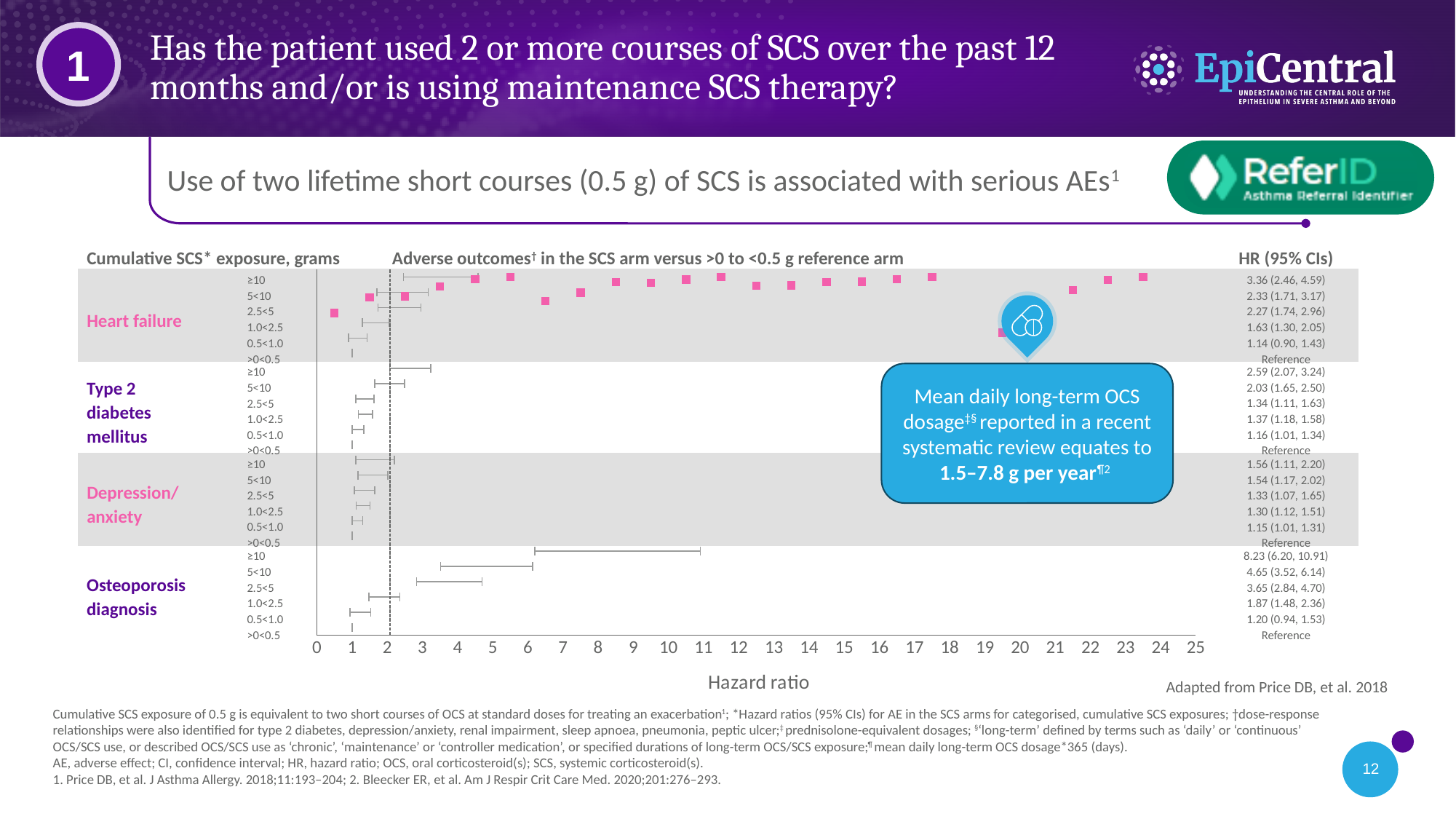
How many adverse outcome groups are shown in the chart? 4 What is the HR (95% CI) for type 2 diabetes mellitus at cumulative SCS exposure 0.5<1.0 g? 1.16 (1.01, 1.34) What is the HR (95% CI) for osteoporosis diagnosis at cumulative SCS exposure ≥10 g? 8.23 (6.20, 10.91) Which is larger: the hazard ratio for osteoporosis diagnosis at ≥10 g or for depression/anxiety at ≥10 g? Osteoporosis diagnosis at ≥10 g Is the hazard ratio for osteoporosis diagnosis at ≥10 g greater or less than 5? greater Which adverse outcome has the lowest hazard ratio at cumulative SCS exposure ≥10 g? Depression/anxiety What kind of chart is shown on the slide? Forest plot How many cumulative SCS exposure categories are listed for each adverse outcome? 6 Which adverse outcome has the highest hazard ratio at cumulative SCS exposure ≥10 g? Osteoporosis diagnosis What is the HR (95% CI) for heart failure at cumulative SCS exposure 5<10 g? 2.33 (1.71, 3.17) What is the difference between the hazard ratio for heart failure at ≥10 g and at 0.5<1.0 g? 2.22 Within the osteoporosis diagnosis group, do hazard ratios rise or fall as cumulative SCS exposure increases? Rise